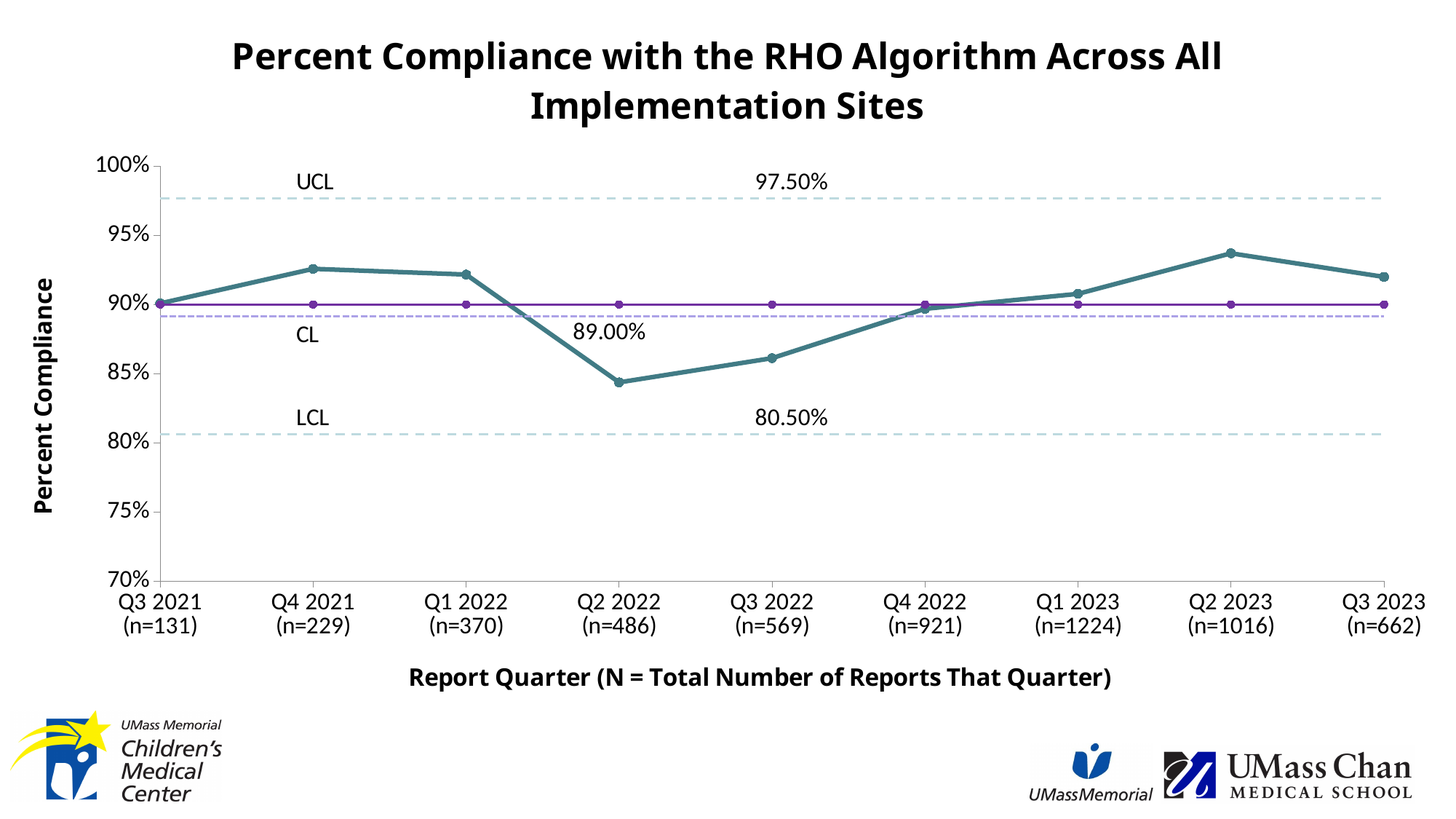
How many report quarters are plotted along the x axis? 9 What is the value of the center line (CL) shown on the chart? 89.00% Which has the higher percent compliance, Q4 2021 or Q3 2022? Q4 2021 Which report quarter has the highest percent compliance? Q2 2023 Does percent compliance rise or fall from Q2 2022 to Q2 2023? Rise What is the value of the lower control limit (LCL) shown on the chart? 80.50% Is the percent compliance for Q2 2023 greater or less than 90%? greater What kind of chart is shown on the slide? Line chart What is the total number of reports (n) for Q1 2023 as shown on the x axis? n=1224 Which report quarter has the lowest percent compliance? Q2 2022 Is the percent compliance for Q2 2022 greater or less than 85%? less What is the value of the upper control limit (UCL) shown on the chart? 97.50%